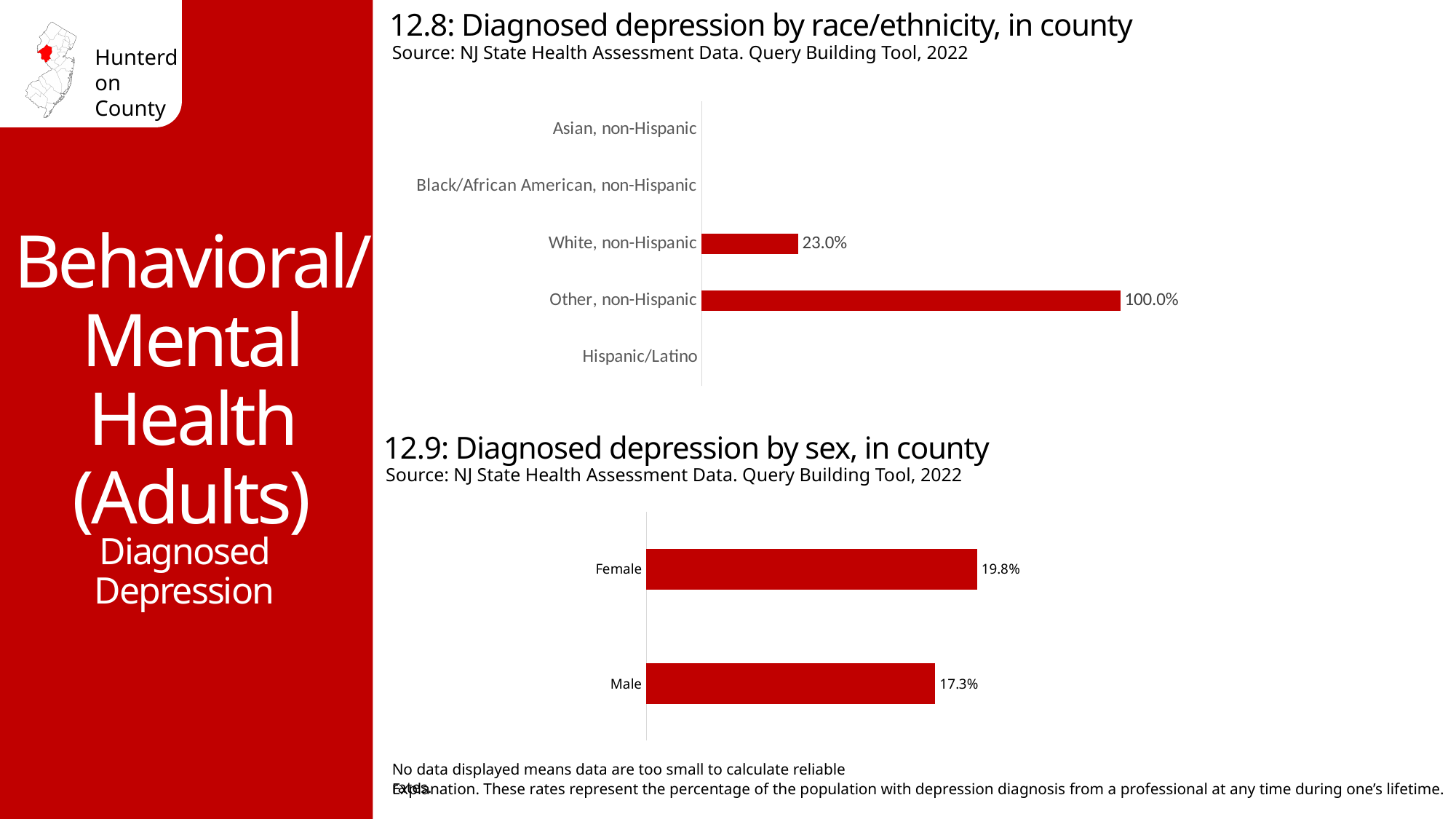
In the chart '12.8: Diagnosed depression by race/ethnicity, in county', which category has the highest value? Other, non-Hispanic In the chart '12.9: Diagnosed depression by sex, in county', what is the value for Male? 17.3% In the chart '12.8: Diagnosed depression by race/ethnicity, in county', how many categories have a bar displayed? 2 In the chart '12.8: Diagnosed depression by race/ethnicity, in county', what is the value for Other, non-Hispanic? 100.0% What kind of chart is '12.8: Diagnosed depression by race/ethnicity, in county'? Bar chart In the chart '12.9: Diagnosed depression by sex, in county', which is larger, Female or Male? Female In the chart '12.8: Diagnosed depression by race/ethnicity, in county', what is the value for White, non-Hispanic? 23.0% In the chart '12.8: Diagnosed depression by race/ethnicity, in county', what is the difference between the values for Other, non-Hispanic and White, non-Hispanic? 77.0% In the chart '12.9: Diagnosed depression by sex, in county', what is the value for Female? 19.8% In the chart '12.9: Diagnosed depression by sex, in county', what is the difference between the Female and Male values? 2.5% In the chart '12.8: Diagnosed depression by race/ethnicity, in county', how many categories are listed on the axis? 5 What is the source cited for the chart '12.9: Diagnosed depression by sex, in county'? NJ State Health Assessment Data. Query Building Tool, 2022